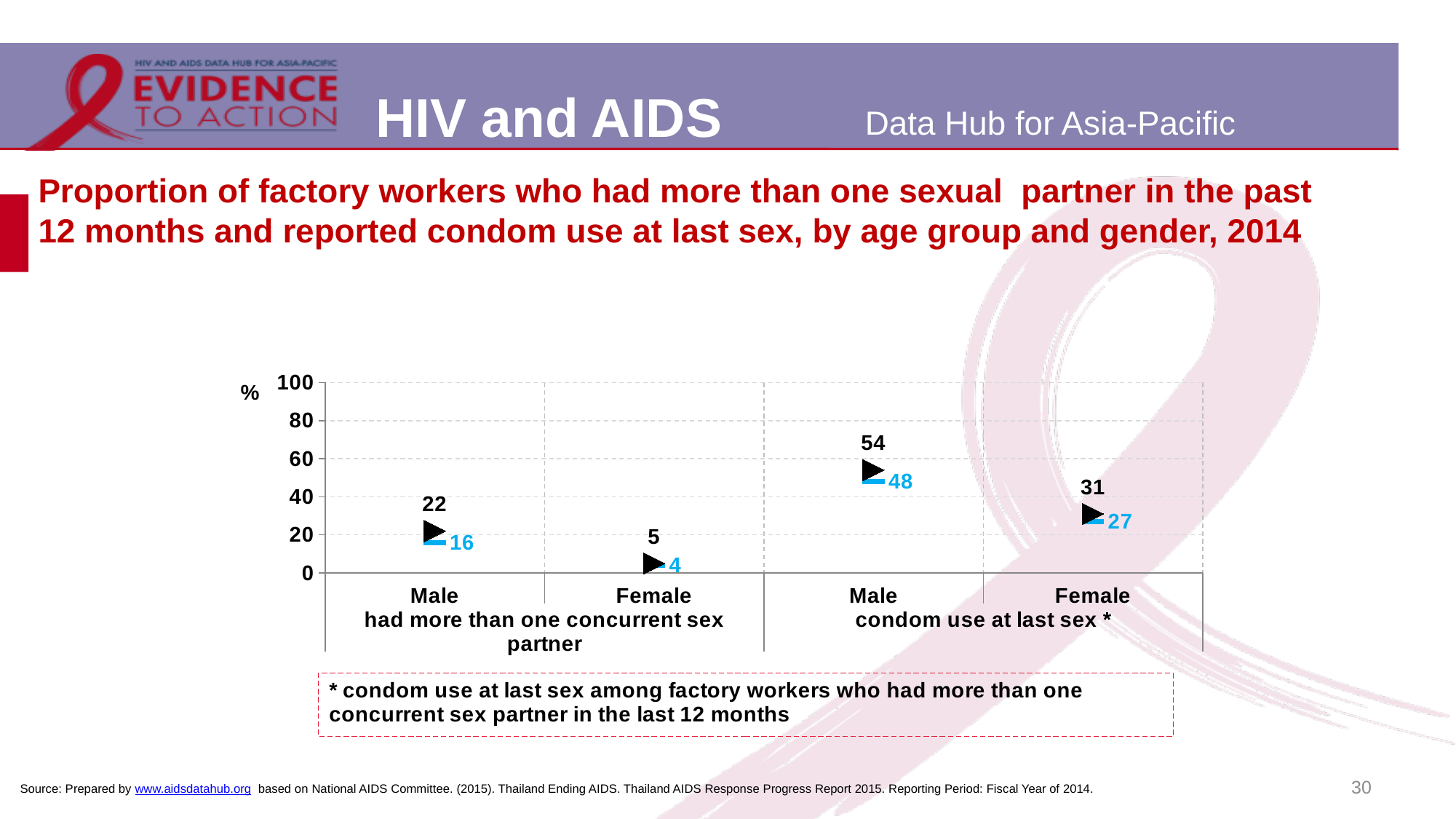
What is the black triangle value for Male under 'condom use at last sex *'? 54 What is the maximum value shown on the y axis? 100 Is the black triangle value for Female under 'condom use at last sex *' greater or less than 40? less What is the black triangle value for Male under 'had more than one concurrent sex partner'? 22 Which is larger: the blue value for Male under 'condom use at last sex *' or the blue value for Female under 'condom use at last sex *'? Male What is the blue value for Female under 'had more than one concurrent sex partner'? 4 How many categories are shown on the x axis? 4 Which category has the lowest blue value? Female, had more than one concurrent sex partner Which category has the highest black triangle value? Male, condom use at last sex * What is the blue value for Female under 'condom use at last sex *'? 27 What is the difference between the black triangle value and the blue value for Male under 'condom use at last sex *'? 6 What is the difference between the black triangle values for Male and Female under 'had more than one concurrent sex partner'? 17